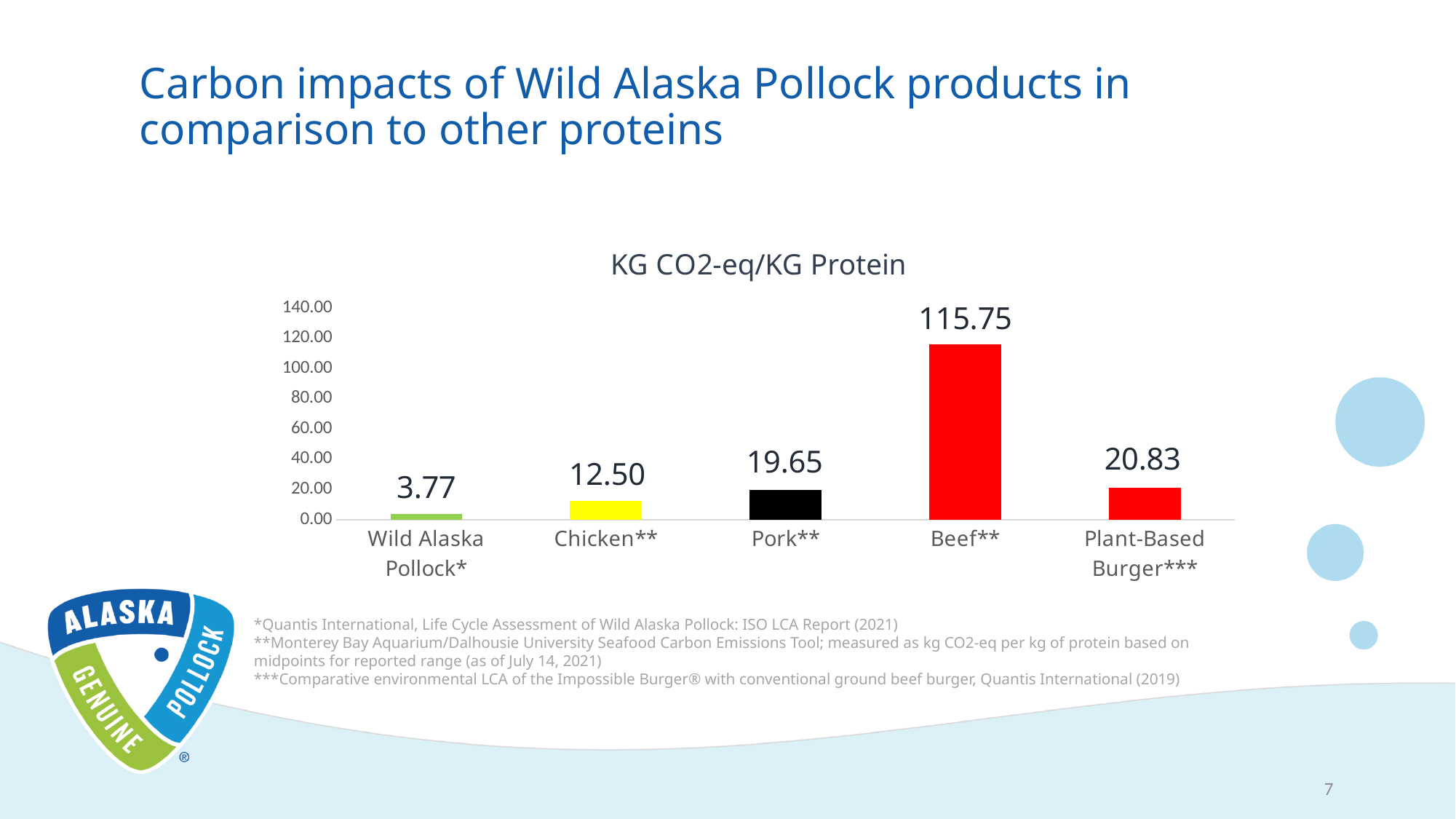
Which category has the lowest value in the chart? Wild Alaska Pollock* What is the value for Beef** in the chart? 115.75 Which has a larger value, Plant-Based Burger*** or Pork**? Plant-Based Burger*** Is the value for Beef** greater or less than 100.00? greater What is the value for Plant-Based Burger*** in the chart? 20.83 What is the difference between the values for Beef** and Wild Alaska Pollock*? 111.98 What is the title of the chart? KG CO2-eq/KG Protein What kind of chart is shown on the slide? Bar chart How many categories are shown in the chart? 5 What is the difference between the values for Pork** and Chicken**? 7.15 What is the value for Wild Alaska Pollock* in the chart? 3.77 Which category has the highest value in the chart? Beef**